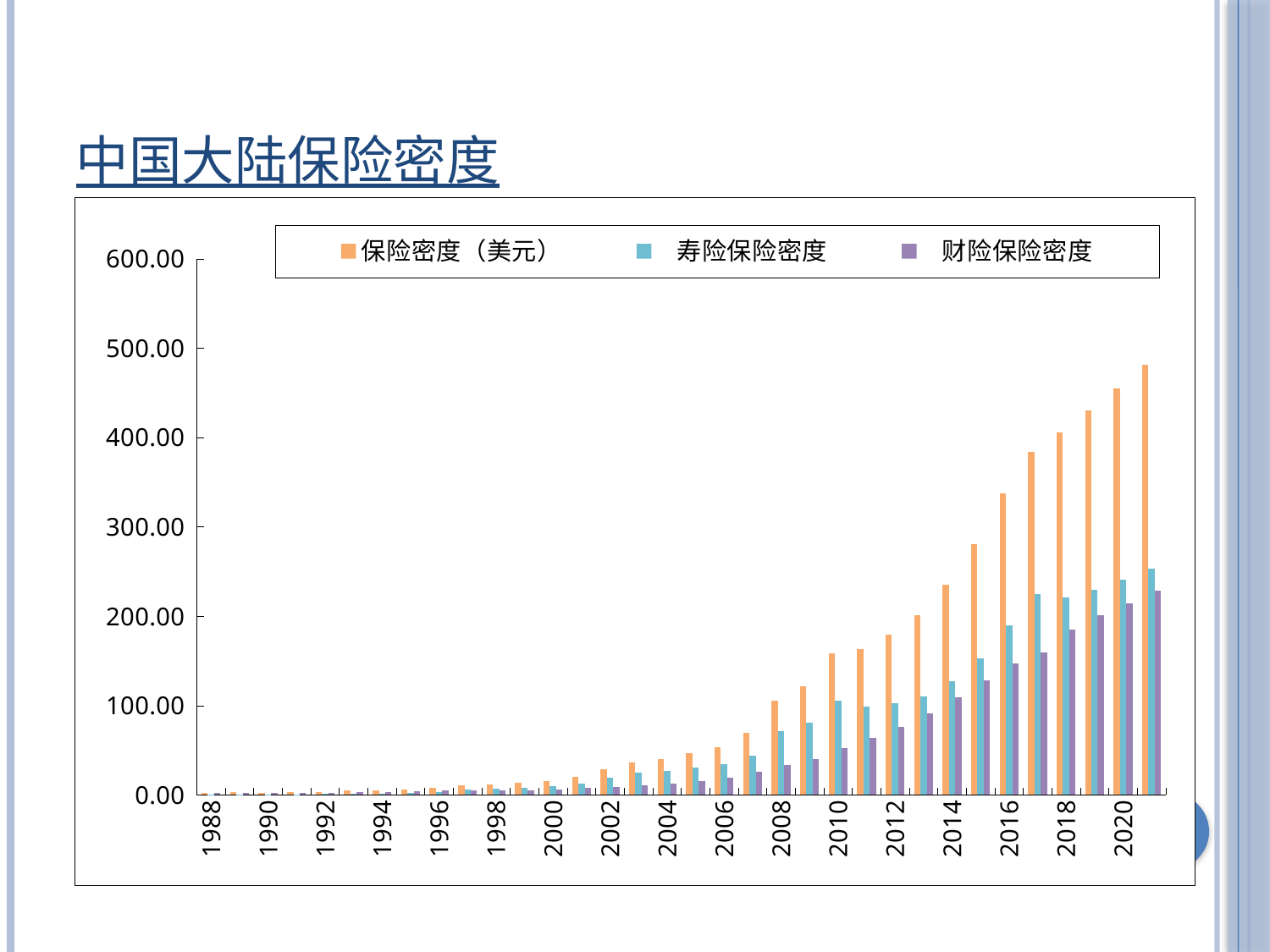
Is the value of 财险保险密度 for 2012 greater or less than 100.00? less Is the value of 保险密度（美元） for 2016 greater or less than 300.00? greater How many series does the legend list? 3 Which year has the larger 保险密度（美元）: 2000 or 2010? 2010 Which colour represents 保险密度（美元） in the legend? orange In 2020, which is larger: 寿险保险密度 or 财险保险密度? 寿险保险密度 What is the title of the chart? 中国大陆保险密度 Is the value of 寿险保险密度 for 2018 greater or less than 200.00? greater Do the values of 保险密度（美元） rise or fall from 1988 to 2020? rise What kind of chart is shown on the slide? bar chart